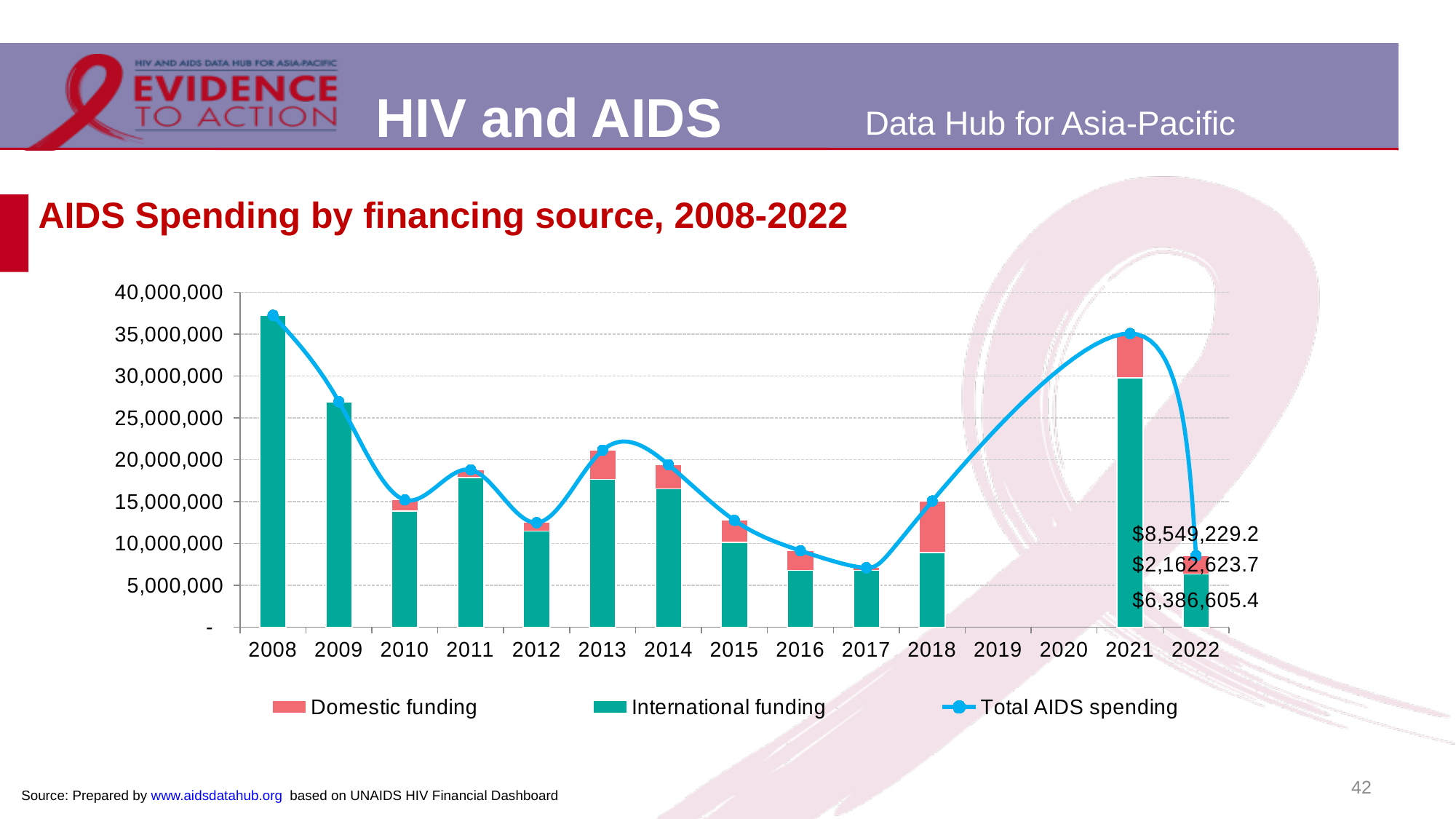
Does Total AIDS spending rise or fall from 2014 to 2017? fall Which year has higher Total AIDS spending, 2009 or 2010? 2009 Which year has the highest Total AIDS spending? 2008 What is the Total AIDS spending value labelled for 2022? $8,549,229.2 Is the Total AIDS spending for 2008 greater or less than 35,000,000? greater What is the International funding value labelled for 2022? $6,386,605.4 Among the years with data, which year has the lowest Total AIDS spending? 2017 Is the Total AIDS spending for 2017 greater or less than 10,000,000? less What is the Domestic funding value labelled for 2022? $2,162,623.7 In 2022, how much larger is International funding than Domestic funding? $4,223,981.7 What kind of chart is shown on the slide? A combined stacked bar and line chart How many series does the legend list? 3